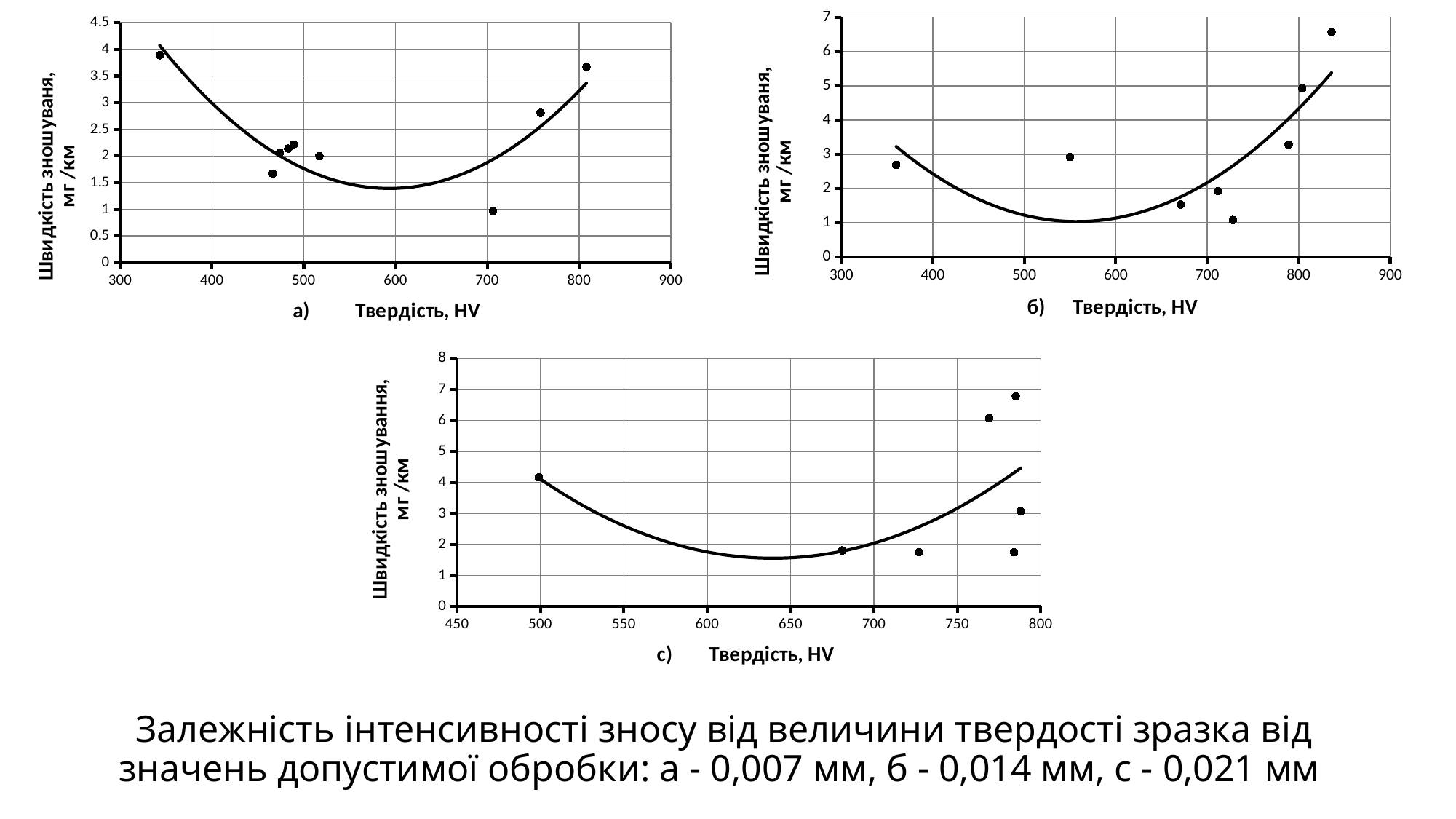
In chart c), is the value of the data point at 500 HV greater or less than 3? greater What kind of chart is chart a)? scatter chart with a fitted curve In chart a), is the value of the data point near 705 HV greater or less than 1.5? less What is the x-axis label of chart б)? Твердість, HV In chart a), does the fitted curve rise or fall as hardness increases from 300 to 500 HV? fall In chart a), is the value of the data point near 345 HV greater or less than 3.5? greater How many data points are plotted in chart б)? 8 In chart c), does the fitted curve rise or fall as hardness increases from 700 to 800 HV? rise How many data points are plotted in chart c)? 7